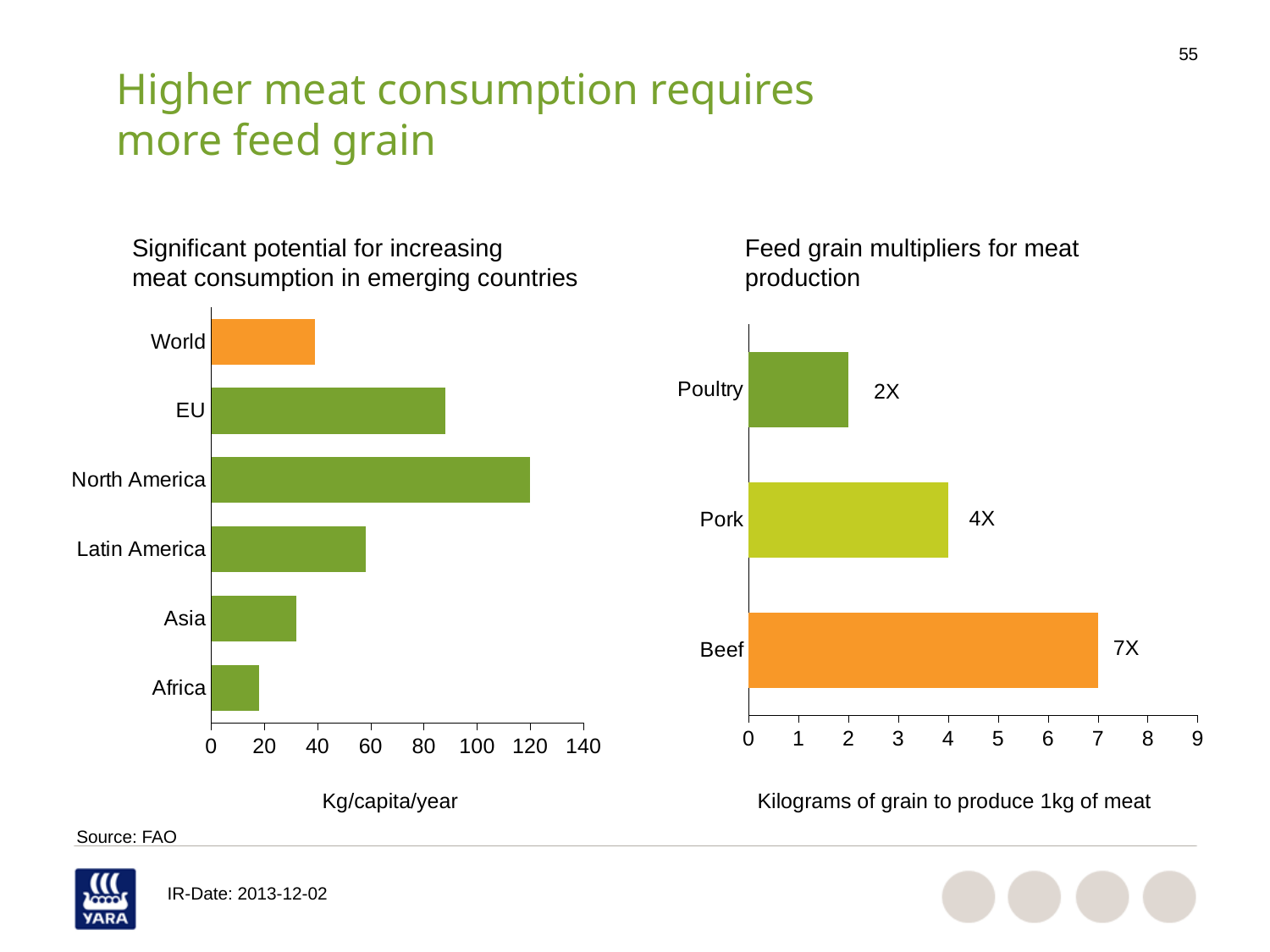
What kind of chart is the 'Significant potential for increasing meat consumption in emerging countries' chart? Bar chart In the 'Feed grain multipliers for meat production' chart, what is the value for Beef? 7X In the 'Feed grain multipliers for meat production' chart, what is the value for Pork? 4X In the 'Significant potential for increasing meat consumption in emerging countries' chart, which region has the lowest meat consumption? Africa In the 'Significant potential for increasing meat consumption in emerging countries' chart, which region has the highest meat consumption? North America In the 'Significant potential for increasing meat consumption in emerging countries' chart, is the value for EU greater or less than 80? greater In the 'Feed grain multipliers for meat production' chart, what is the value for Poultry? 2X In the 'Significant potential for increasing meat consumption in emerging countries' chart, is the value for Asia greater or less than 40? less In the 'Feed grain multipliers for meat production' chart, how many meat categories are shown? 3 In the 'Feed grain multipliers for meat production' chart, which meat has the highest feed grain multiplier? Beef In the 'Feed grain multipliers for meat production' chart, what is the difference between the Beef and Poultry multipliers? 5X In the 'Significant potential for increasing meat consumption in emerging countries' chart, which is larger, the value for Latin America or the value for World? Latin America